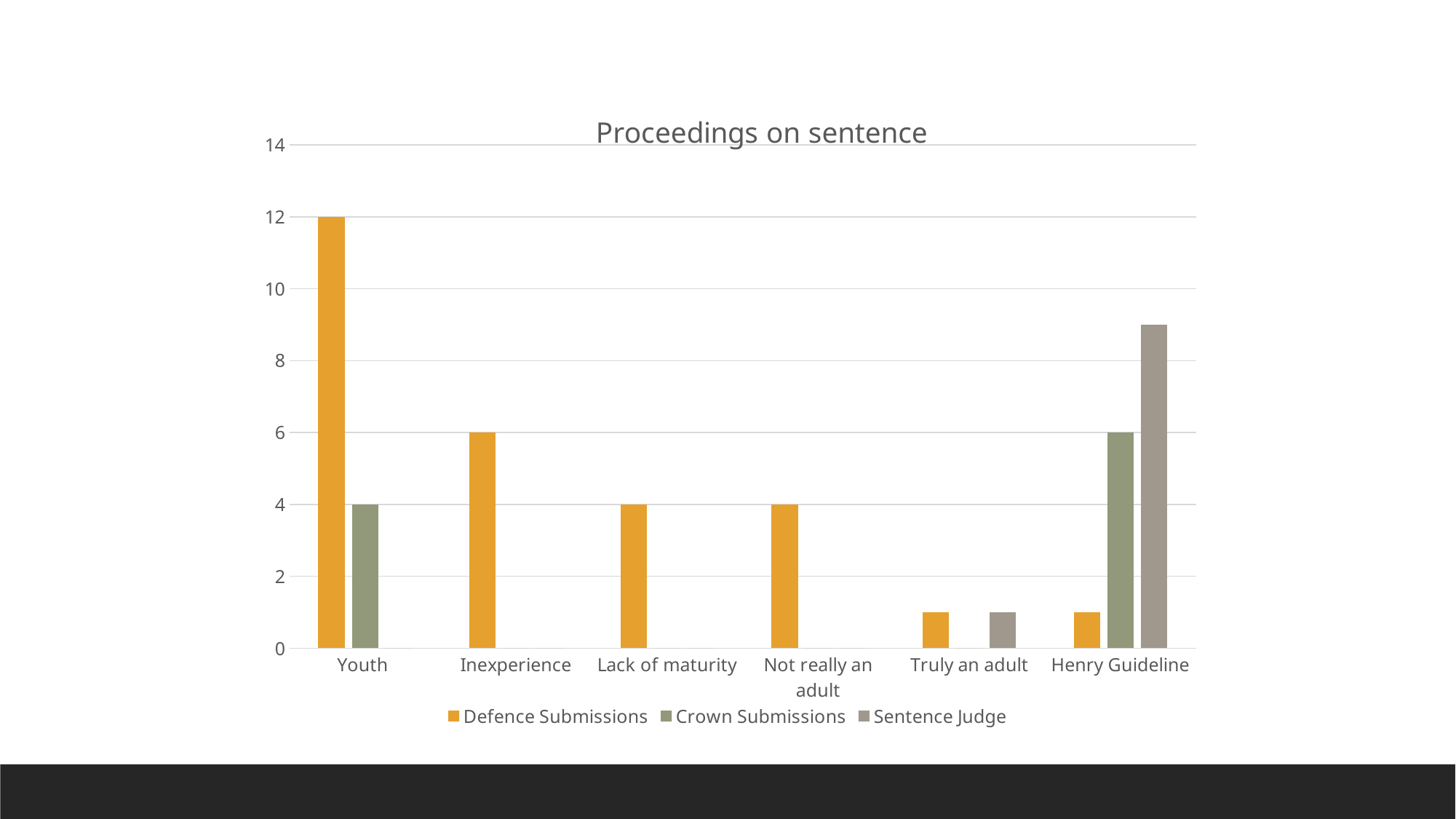
What is the Crown Submissions value for Youth? 4 What is the title of the chart? Proceedings on sentence Which category has the highest Defence Submissions value? Youth What is the Defence Submissions value for Inexperience? 6 What is the difference between the Defence Submissions and Crown Submissions values for Youth? 8 How many categories are shown on the x axis? 6 Which has the larger Crown Submissions value, Youth or Henry Guideline? Henry Guideline Is the Sentence Judge value for Henry Guideline greater or less than 8? greater How many series does the legend list? 3 What is the Crown Submissions value for Henry Guideline? 6 What kind of chart is shown on the slide? bar chart What is the Defence Submissions value for Youth? 12